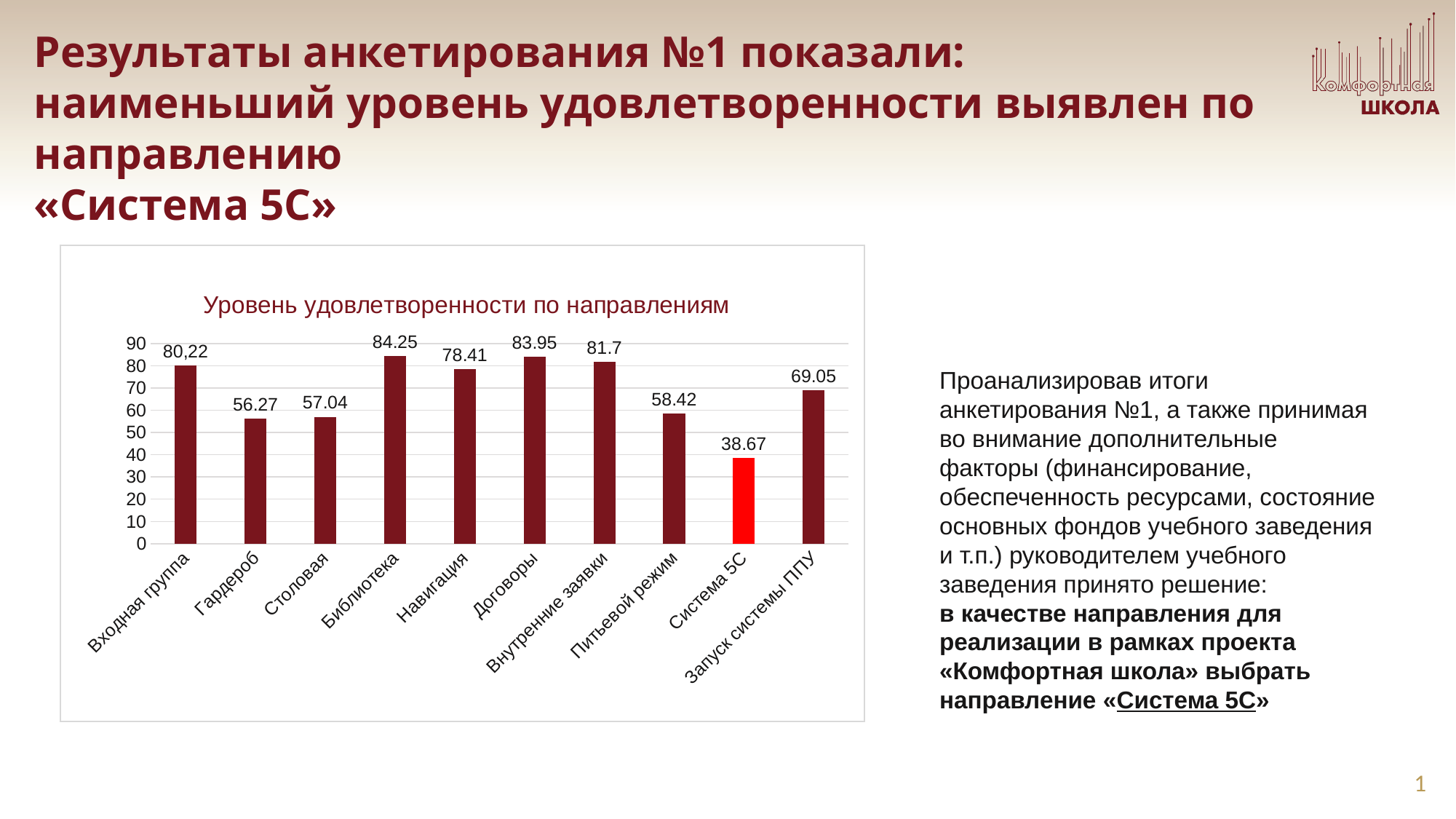
Which category has the highest value? Библиотека What is the value for Запуск системы ППУ? 69.05 Which category's bar is coloured bright red instead of dark red? Система 5С Which is larger, the value for Навигация or the value for Внутренние заявки? Внутренние заявки How many categories are shown in the chart? 10 What is the value for Библиотека? 84.25 What is the difference between the values for Запуск системы ППУ and Питьевой режим? 10.63 What is the difference between the values for Библиотека and Система 5С? 45.58 What kind of chart is shown on the slide? Bar chart What is the value for Система 5С? 38.67 What is the value for Входная группа? 80,22 Which category has the lowest value? Система 5С